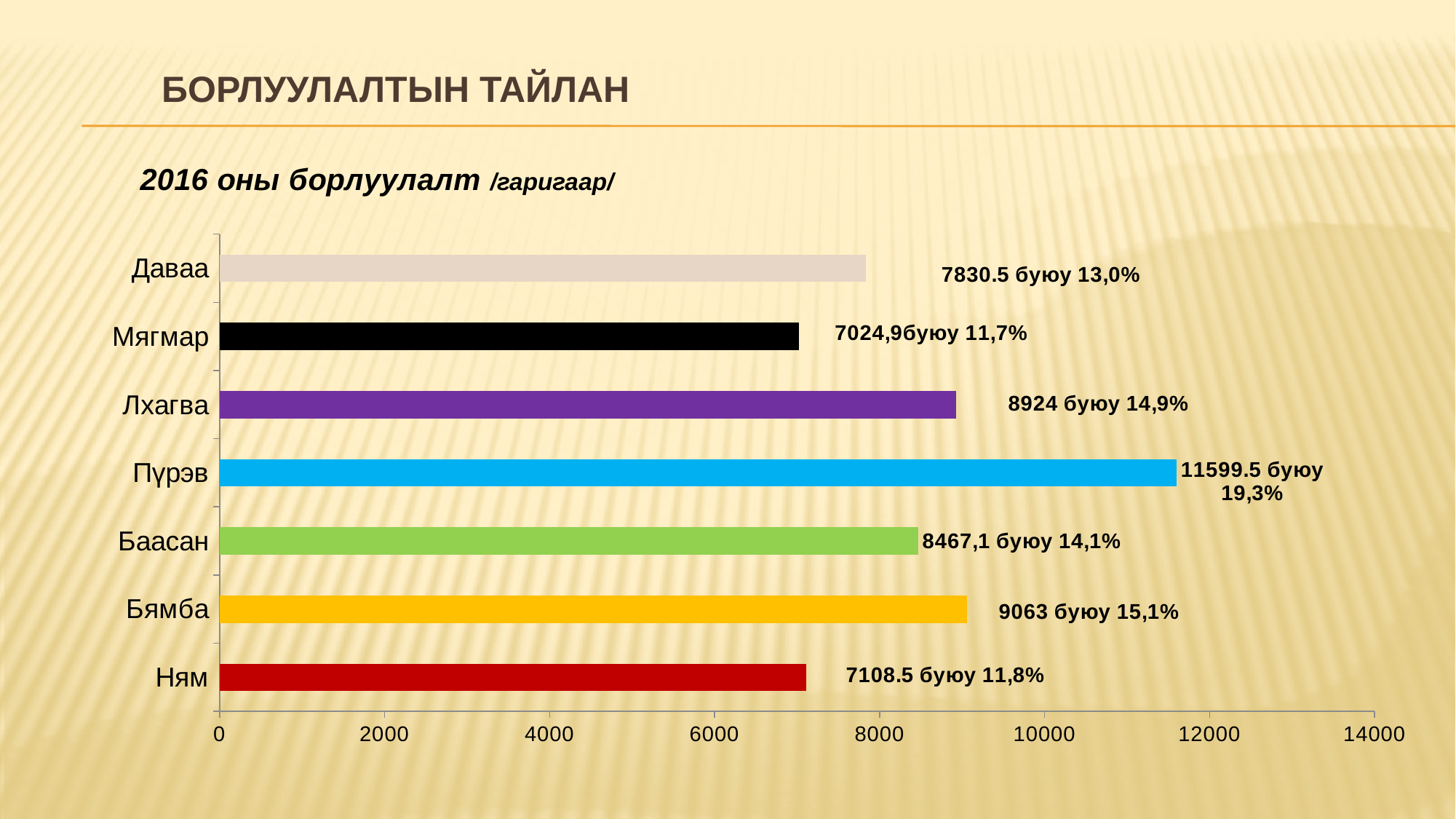
Which day has the highest value? Пүрэв What percentage is shown for Мягмар? 11,7% What kind of chart is shown on the slide? bar chart What is the value for Даваа? 7830.5 Is the value for Даваа greater or less than 8000? less What is the difference between the values for Пүрэв and Даваа? 3769 How many days are shown in the chart? 7 Which is larger, the value for Баасан or the value for Ням? Баасан What is the difference between the values for Бямба and Лхагва? 139 What is the value for Бямба? 9063 What percentage share is shown for Пүрэв? 19,3% Which day has the lowest value? Мягмар